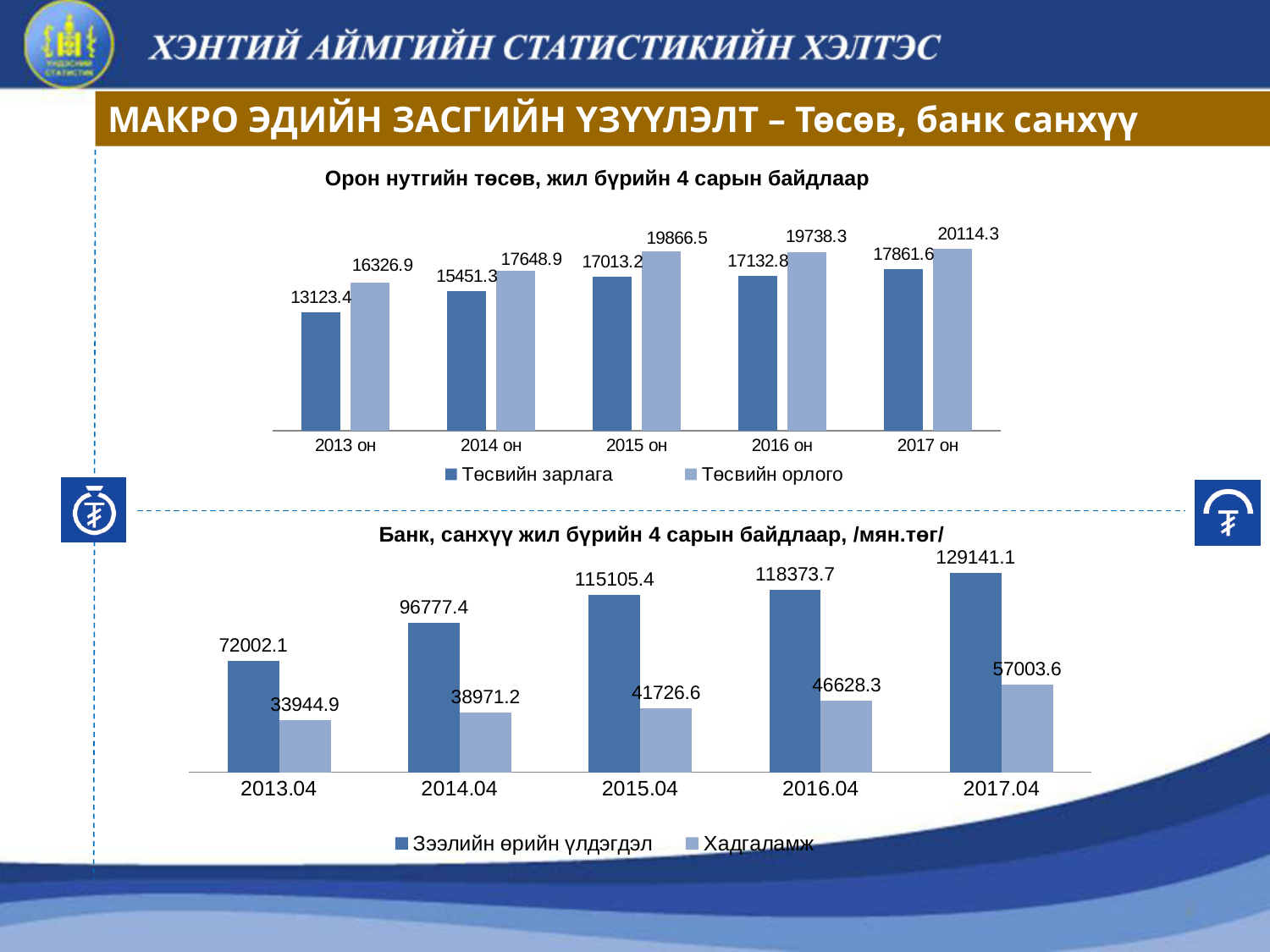
In the top chart (Орон нутгийн төсөв), how many series does the legend list? 2 In the top chart (Орон нутгийн төсөв), does Төсвийн зарлага rise or fall from 2013 он to 2017 он? rise In the bottom chart (Банк, санхүү), what is the value of Хадгаламж for 2013.04? 33944.9 What type of chart is the bottom chart (Банк, санхүү)? bar chart In the top chart (Орон нутгийн төсөв), which year has the highest Төсвийн орлого value? 2017 он In the top chart (Орон нутгийн төсөв), what is the difference between Төсвийн орлого and Төсвийн зарлага in 2015 он? 2853.3 In the bottom chart (Банк, санхүү), how many periods are shown on the x axis? 5 In the top chart (Орон нутгийн төсөв), what is the value of Төсвийн орлого for 2017 он? 20114.3 In the bottom chart (Банк, санхүү), what is the value of Зээлийн өрийн үлдэгдэл for 2015.04? 115105.4 In the bottom chart (Банк, санхүү), which period has the lowest Хадгаламж value? 2013.04 In the bottom chart (Банк, санхүү), what is the difference between Зээлийн өрийн үлдэгдэл and Хадгаламж in 2017.04? 72137.5 In the top chart (Орон нутгийн төсөв), what is the value of Төсвийн зарлага for 2013 он? 13123.4